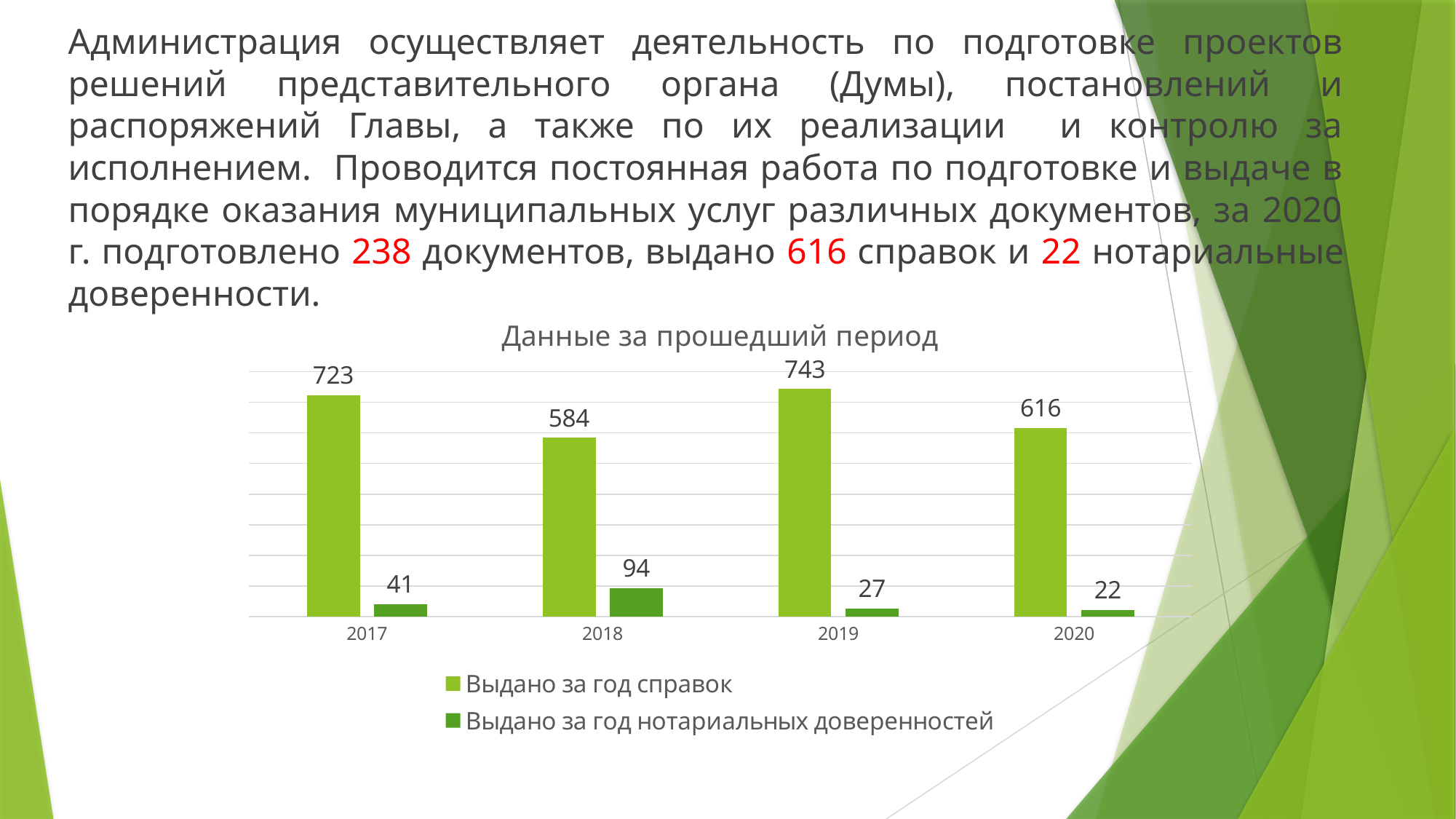
What is the value for 'Выдано за год нотариальных доверенностей' in 2018? 94 What is the value for 'Выдано за год справок' in 2020? 616 What is the value for 'Выдано за год справок' in 2019? 743 How many series does the chart legend list? 2 Which year has the lowest value for 'Выдано за год нотариальных доверенностей'? 2020 What is the title of the chart? Данные за прошедший период Which is larger: 'Выдано за год справок' in 2017 or in 2020? 2017 Which year has the highest value for 'Выдано за год справок'? 2019 How many years are shown on the x axis of the chart? 4 What kind of chart is shown on the slide? bar chart What is the difference between the 'Выдано за год нотариальных доверенностей' values for 2018 and 2019? 67 What is the difference between the 'Выдано за год справок' values for 2017 and 2018? 139